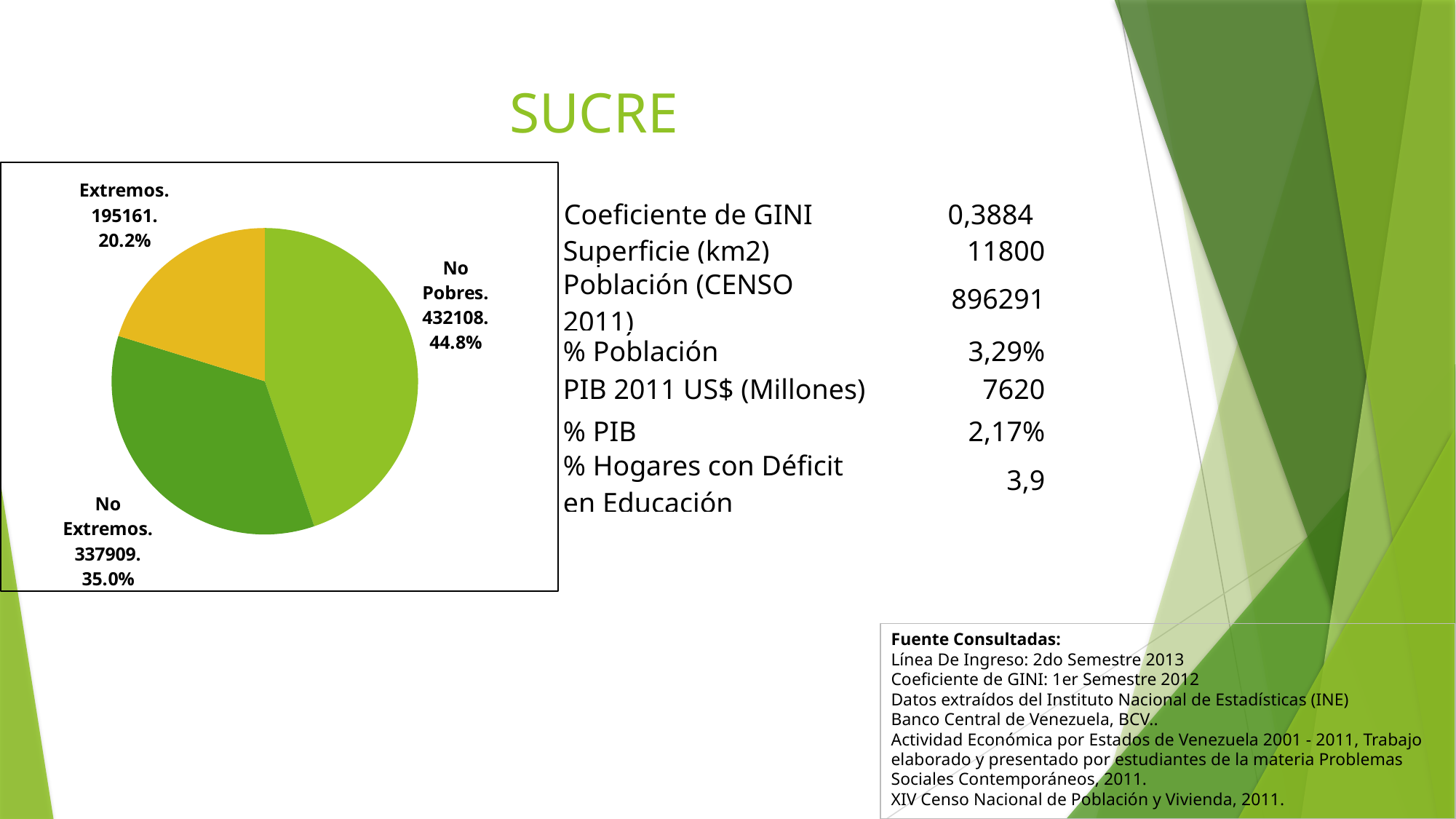
What share of the pie does Extremos represent? 20.2% Which is larger, the value for No Extremos or the value for Extremos? No Extremos What is the difference between the values for No Pobres and No Extremos? 94199 What share of the pie does No Pobres represent? 44.8% What colour is the Extremos slice in the pie chart? yellow Which category has the smallest slice in the pie chart? Extremos What is the value for No Extremos in the pie chart? 337909 What kind of chart is shown on the slide? pie chart How many slices does the pie chart have? 3 What is the value for Extremos in the pie chart? 195161 What is the value for No Pobres in the pie chart? 432108 Which category has the largest slice in the pie chart? No Pobres